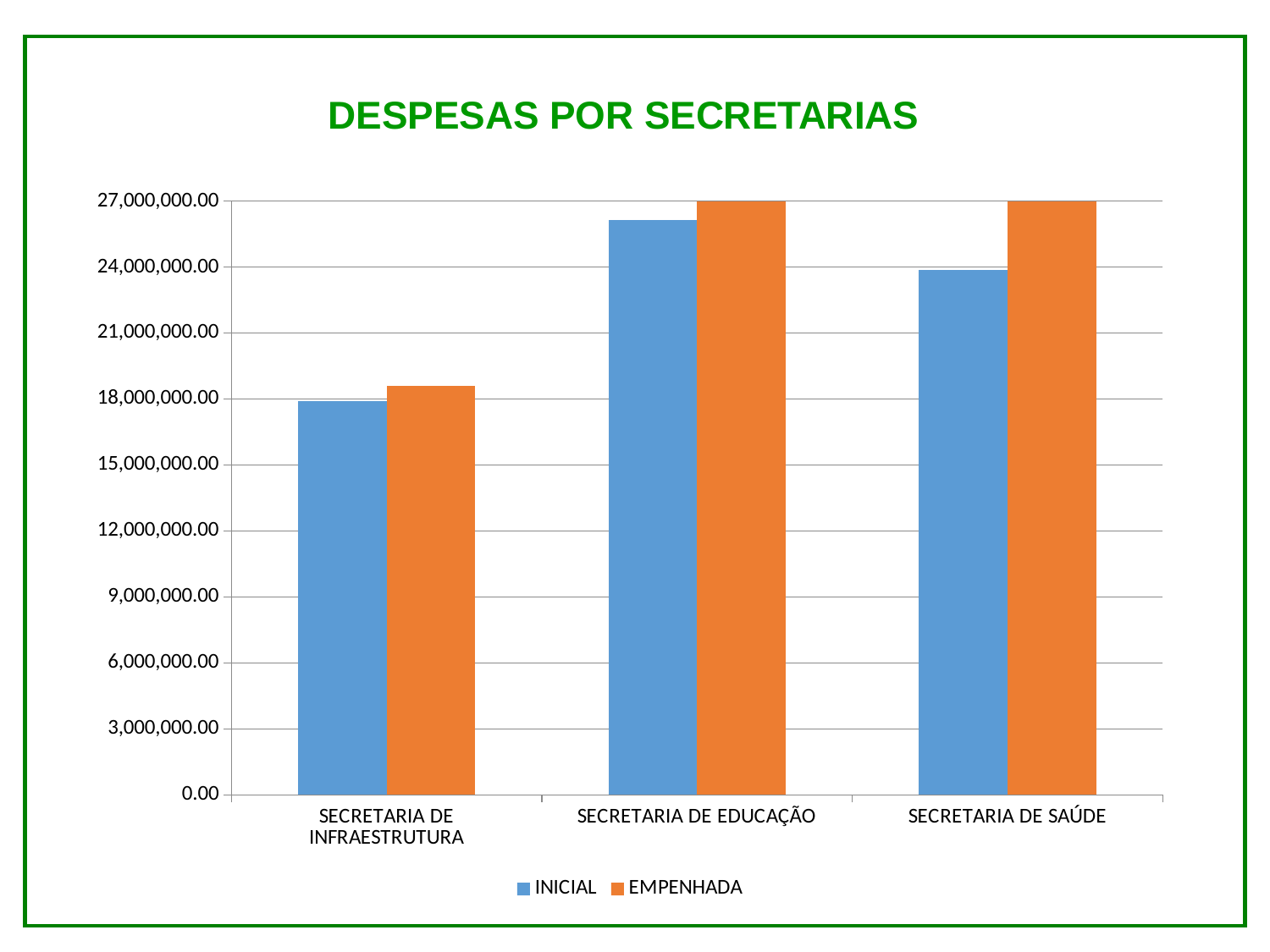
Which category has the lowest INICIAL value? SECRETARIA DE INFRAESTRUTURA Which category has the highest INICIAL value? SECRETARIA DE EDUCAÇÃO How many categories are shown on the x axis? 3 What is the title of the chart? DESPESAS POR SECRETARIAS Which category has the lowest EMPENHADA value? SECRETARIA DE INFRAESTRUTURA Is the INICIAL value for SECRETARIA DE SAÚDE greater or less than 21,000,000.00? greater How many series does the legend list? 2 Which is larger, the INICIAL value for SECRETARIA DE EDUCAÇÃO or the INICIAL value for SECRETARIA DE SAÚDE? SECRETARIA DE EDUCAÇÃO For SECRETARIA DE SAÚDE, which series has the larger value, INICIAL or EMPENHADA? EMPENHADA Is the EMPENHADA value for SECRETARIA DE INFRAESTRUTURA greater or less than 18,000,000.00? greater Is the INICIAL value for SECRETARIA DE EDUCAÇÃO greater or less than 24,000,000.00? greater What type of chart is shown on the slide? bar chart